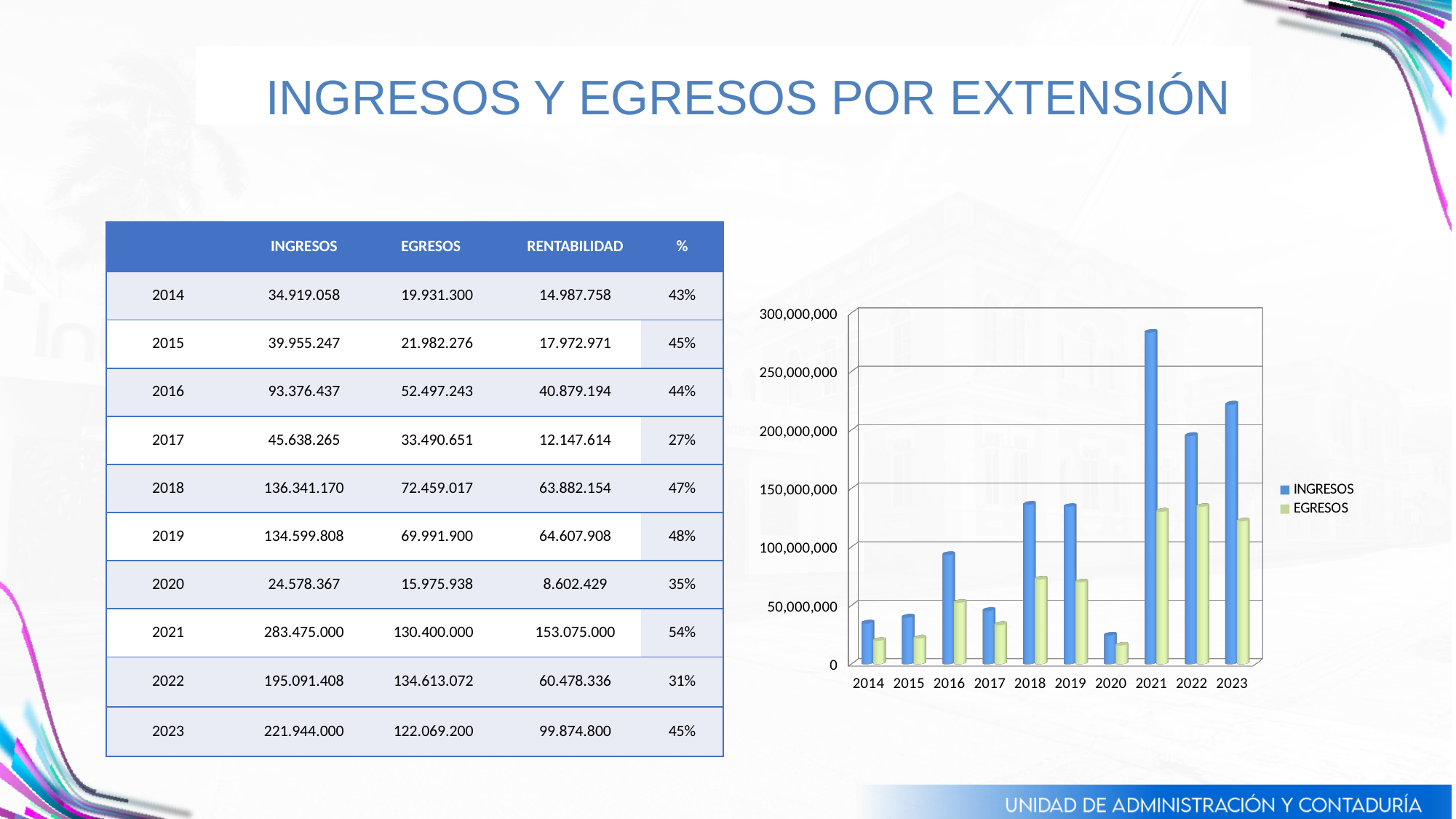
What kind of chart is shown on the right side of the slide? Bar chart Is the EGRESOS value for 2021 greater or less than 100,000,000? greater Which year has the larger INGRESOS bar, 2022 or 2023? 2023 Which year has the highest INGRESOS bar in the chart? 2021 Is the INGRESOS value for 2018 greater or less than 150,000,000? less Which year has the lowest INGRESOS bar in the chart? 2020 Is the INGRESOS value for 2021 greater or less than 250,000,000? greater Did INGRESOS rise or fall from 2019 to 2020 in the chart? fall How many years are shown on the x axis of the chart? 10 Which colour represents the INGRESOS series in the chart? Blue How many series does the chart's legend list? 2